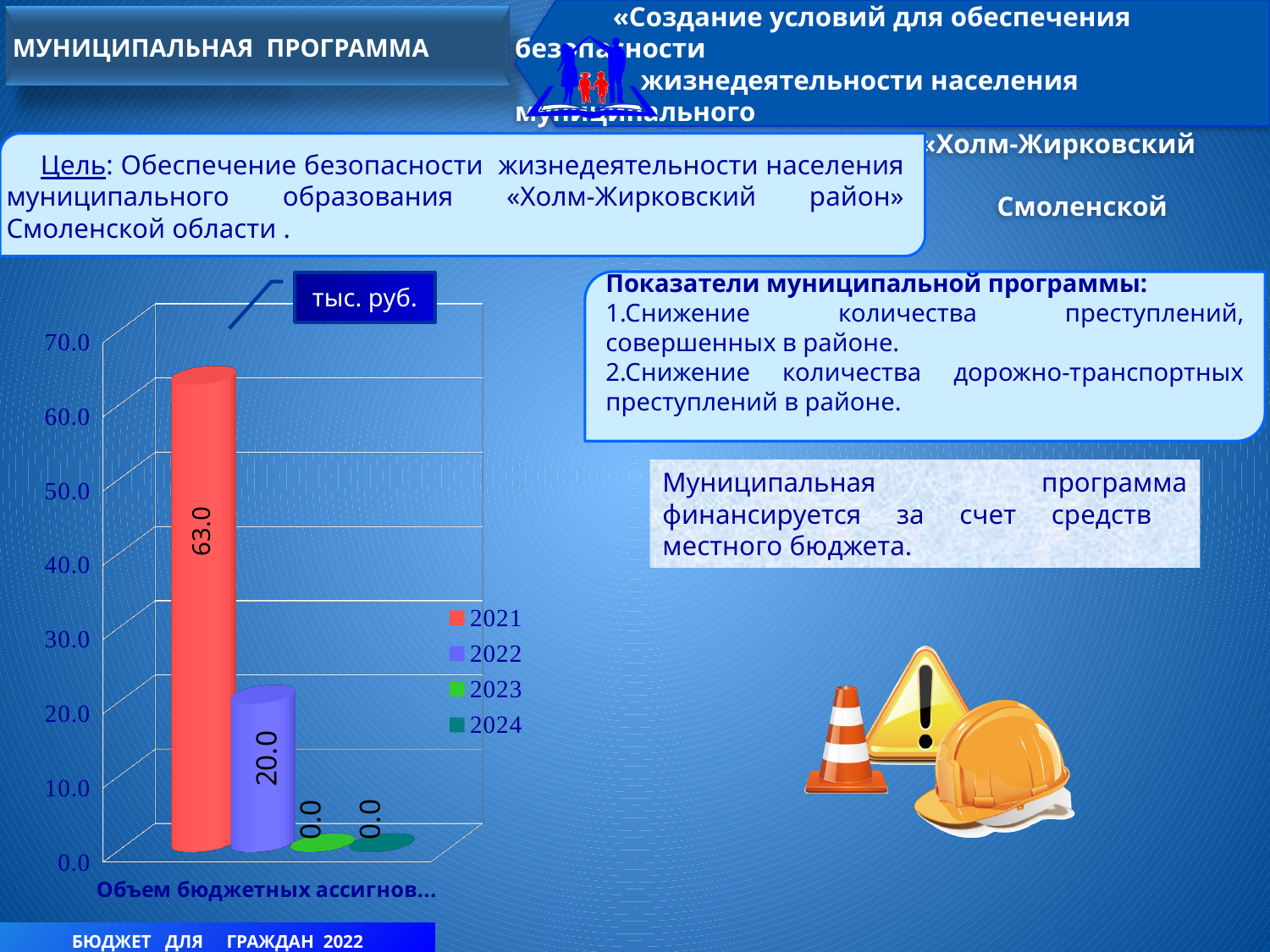
Is the value for 2021 greater or less than 60.0? greater What is the value for 2024 on the chart? 0.0 What is the difference between the values for 2021 and 2022? 43.0 What is the value for 2021 on the chart? 63.0 What is the value for 2022 on the chart? 20.0 What is the value for 2023 on the chart? 0.0 What kind of chart is shown on the slide? bar chart What unit is shown in the label above the chart? тыс. руб. Which year has the highest value on the chart? 2021 How many series does the legend list? 4 Which is larger, the value for 2021 or the value for 2022? 2021 What colour is the bar for 2021? red